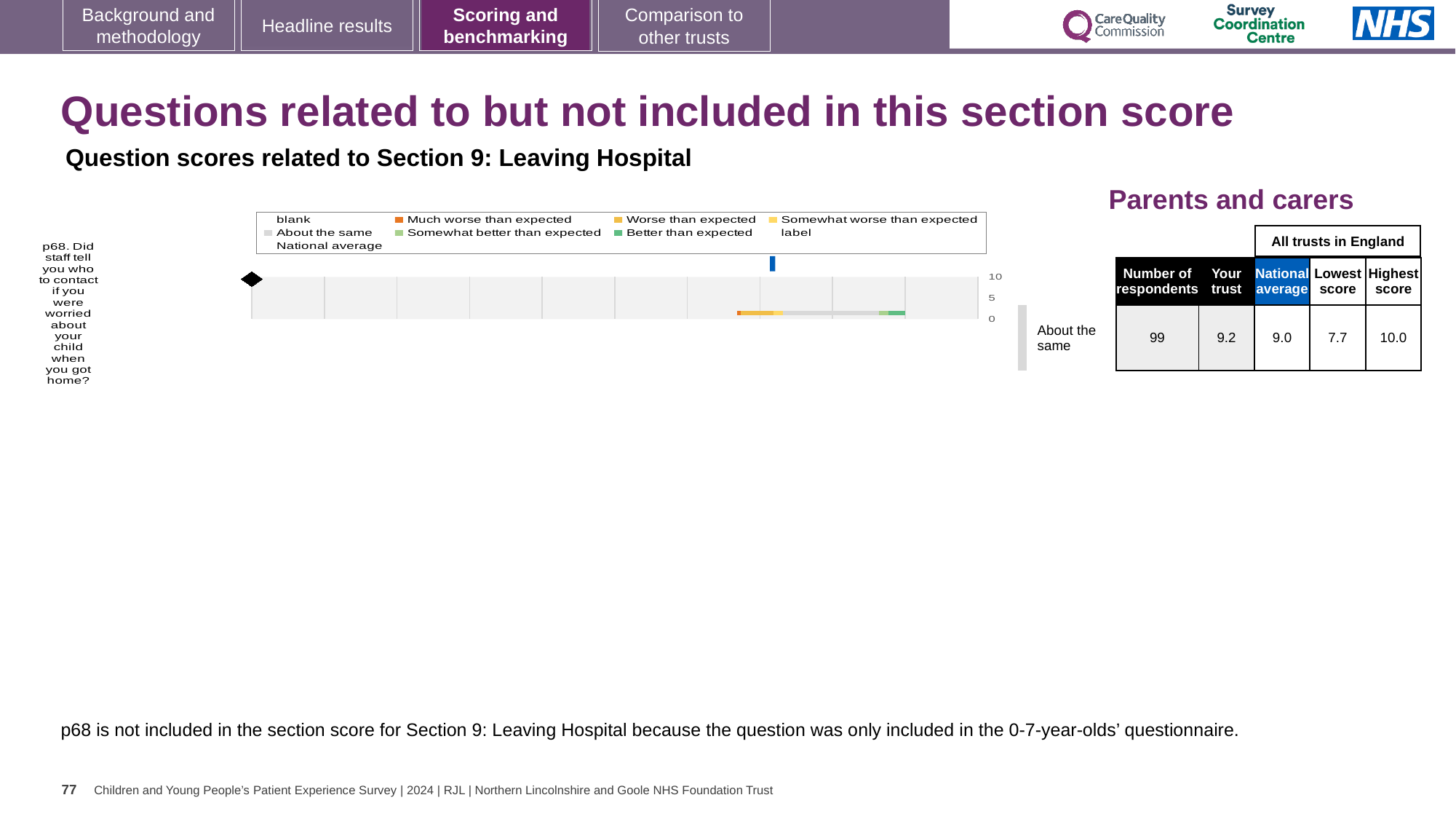
According to the table, what is the 'Your trust' score for p68? 9.2 According to the table, what is the lowest score among all trusts in England for p68? 7.7 How many respondents answered p68 according to the table? 99 What is the difference between the highest score and the lowest score for p68 in the table? 2.3 Which is larger for p68, the 'Your trust' score or the national average? Your trust What benchmark category is the trust's p68 result labelled as next to the chart? About the same What kind of chart is shown on the slide? bar chart According to the table, what is the highest score among all trusts in England for p68? 10.0 How many questions are plotted in the chart? 1 According to the table, what is the national average score for p68? 9.0 What is the highest value shown on the chart's axis? 10 Which question number is plotted in the chart? p68